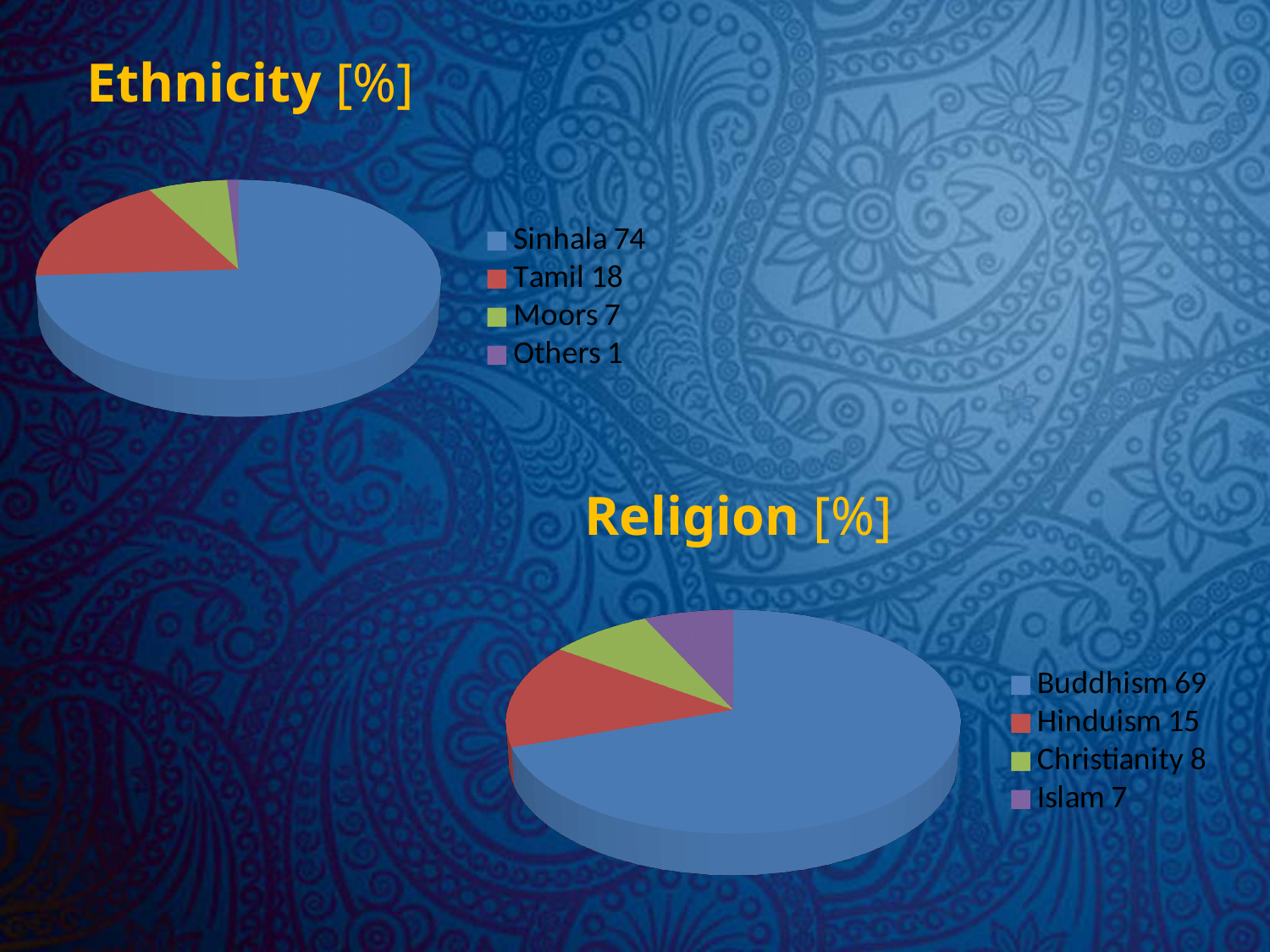
In the Ethnicity [%] chart, which category has the largest slice? Sinhala In the Religion [%] chart, what is the value for Islam? 7 In the Religion [%] chart, which category has the smallest slice? Islam In the Religion [%] chart, what is the value for Hinduism? 15 What type of chart is the Ethnicity [%] chart? Pie chart In the Ethnicity [%] chart, what is the value for Tamil? 18 In the Ethnicity [%] chart, what is the value for Sinhala? 74 In the Ethnicity [%] chart, what is the difference between the Tamil and Moors values? 11 How many categories does the Religion [%] chart show? 4 In the Religion [%] chart, which category has the largest slice? Buddhism In the Ethnicity [%] chart, which category has the smallest slice? Others In the Religion [%] chart, which is larger, Christianity or Islam? Christianity